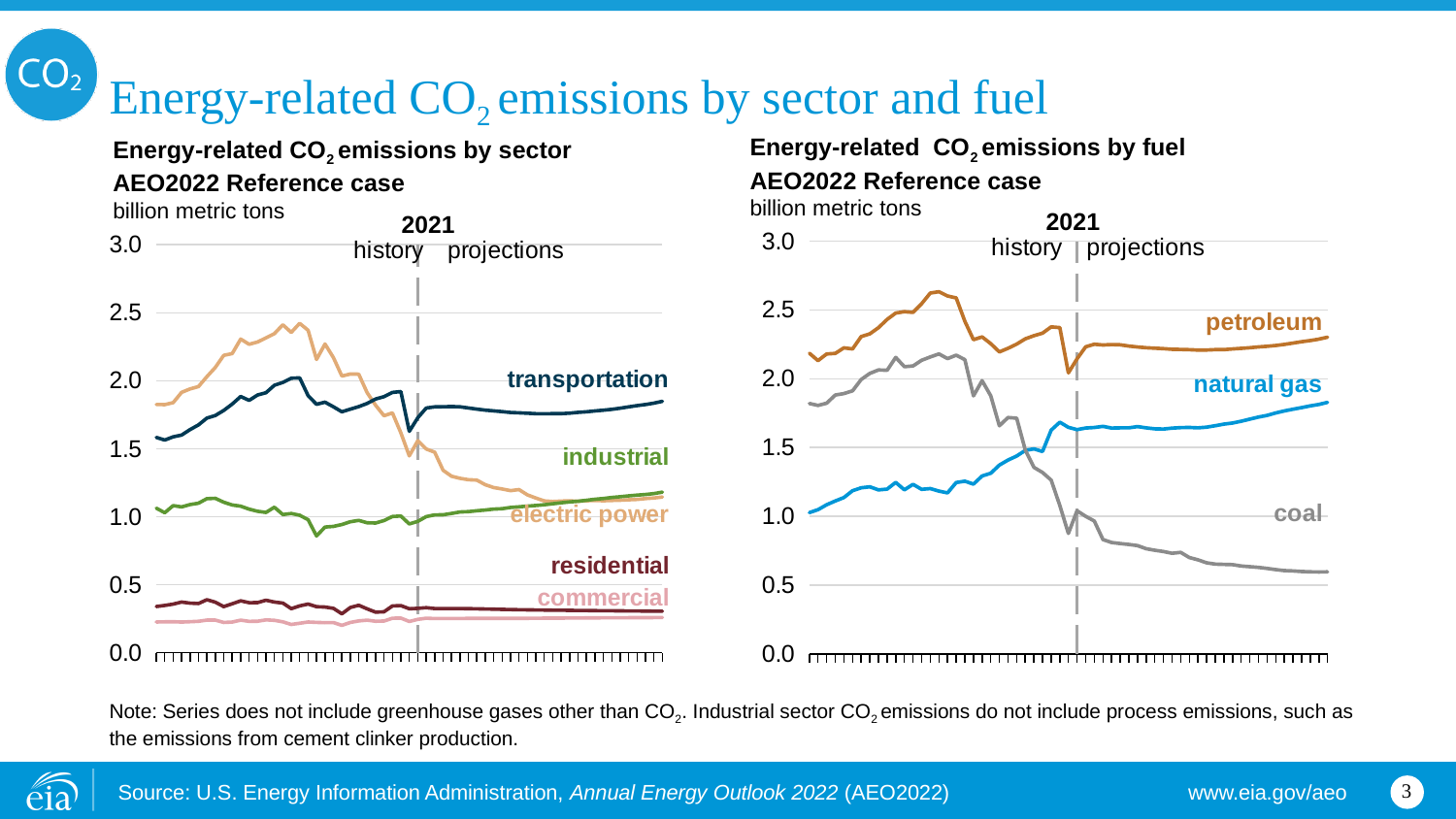
In the 'Energy-related CO2 emissions by fuel' chart, does coal rise or fall over the projection period? fall In the 'Energy-related CO2 emissions by fuel' chart, which fuel has the lowest emissions at the end of the projection period? coal What year separates history from projections in both charts? 2021 In the 'Energy-related CO2 emissions by fuel' chart, is the value for petroleum at the end of the projection period greater or less than 2.0? greater In the 'Energy-related CO2 emissions by fuel' chart, does natural gas rise or fall over the projection period? rise In the 'Energy-related CO2 emissions by fuel' chart, which fuel has the highest emissions at the end of the projection period? petroleum In the 'Energy-related CO2 emissions by sector' chart, which sector has the lowest emissions at the end of the projection period? commercial In the 'Energy-related CO2 emissions by fuel' chart, is the value for coal at the end of the projection period greater or less than 1.0? less How many series are plotted in the 'Energy-related CO2 emissions by fuel' chart? 3 What type of chart is the 'Energy-related CO2 emissions by sector' chart? line chart How many series are plotted in the 'Energy-related CO2 emissions by sector' chart? 5 In the 'Energy-related CO2 emissions by sector' chart, which sector has the highest emissions at the end of the projection period? transportation